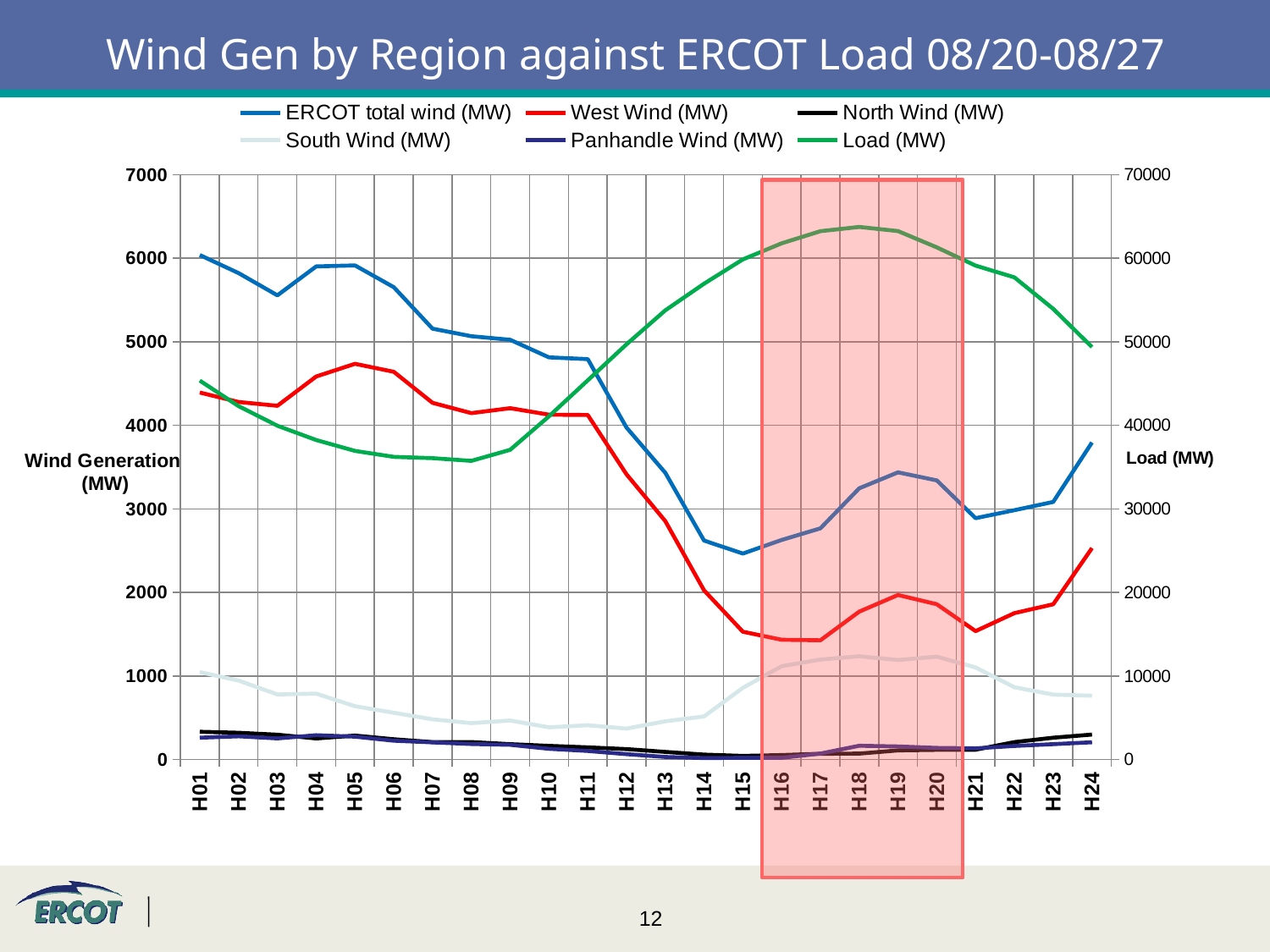
Which is larger, ERCOT total wind (MW) at H01 or at H24? H01 What kind of chart is shown on the slide? line chart Is the value of Load (MW) at H08 greater or less than 40000? less What is the label of the right-hand vertical axis? Load (MW) At which hour is ERCOT total wind (MW) lowest? H15 Is the value of ERCOT total wind (MW) at H15 greater or less than 3000? less Does Load (MW) rise or fall from H08 to H18? rise How many hourly points are plotted along the x axis? 24 How many series does the legend list? 6 Is the value of Load (MW) at H18 greater or less than 60000? greater